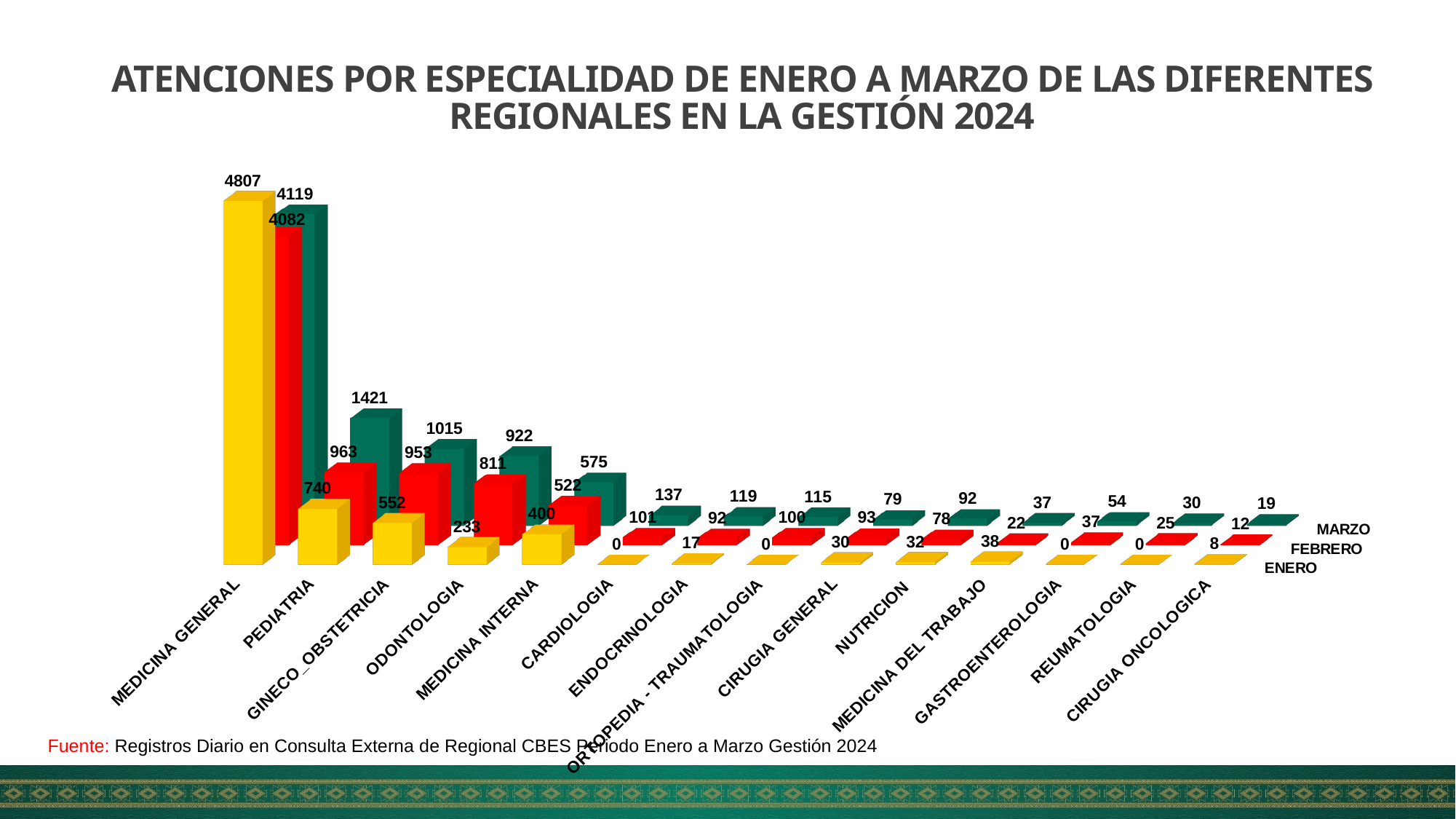
What kind of chart is shown on the slide? bar chart How many specialties (categories) are shown on the x axis? 14 What is the title of the chart? ATENCIONES POR ESPECIALIDAD DE ENERO A MARZO DE LAS DIFERENTES REGIONALES EN LA GESTIÓN 2024 What is the FEBRERO value for GINECO_OBSTETRICIA? 953 Which is larger for CIRUGIA GENERAL, the FEBRERO value or the MARZO value? FEBRERO What is the MARZO value for PEDIATRIA? 1421 What is the difference between the MARZO and FEBRERO values for MEDICINA INTERNA? 53 Which specialty has the lowest MARZO value? CIRUGIA ONCOLOGICA Which specialty has the highest MARZO value? MEDICINA GENERAL What is the ENERO value for MEDICINA GENERAL? 4807 How many series does the chart show (ENERO, FEBRERO, MARZO)? 3 What is the MARZO value for ODONTOLOGIA? 922